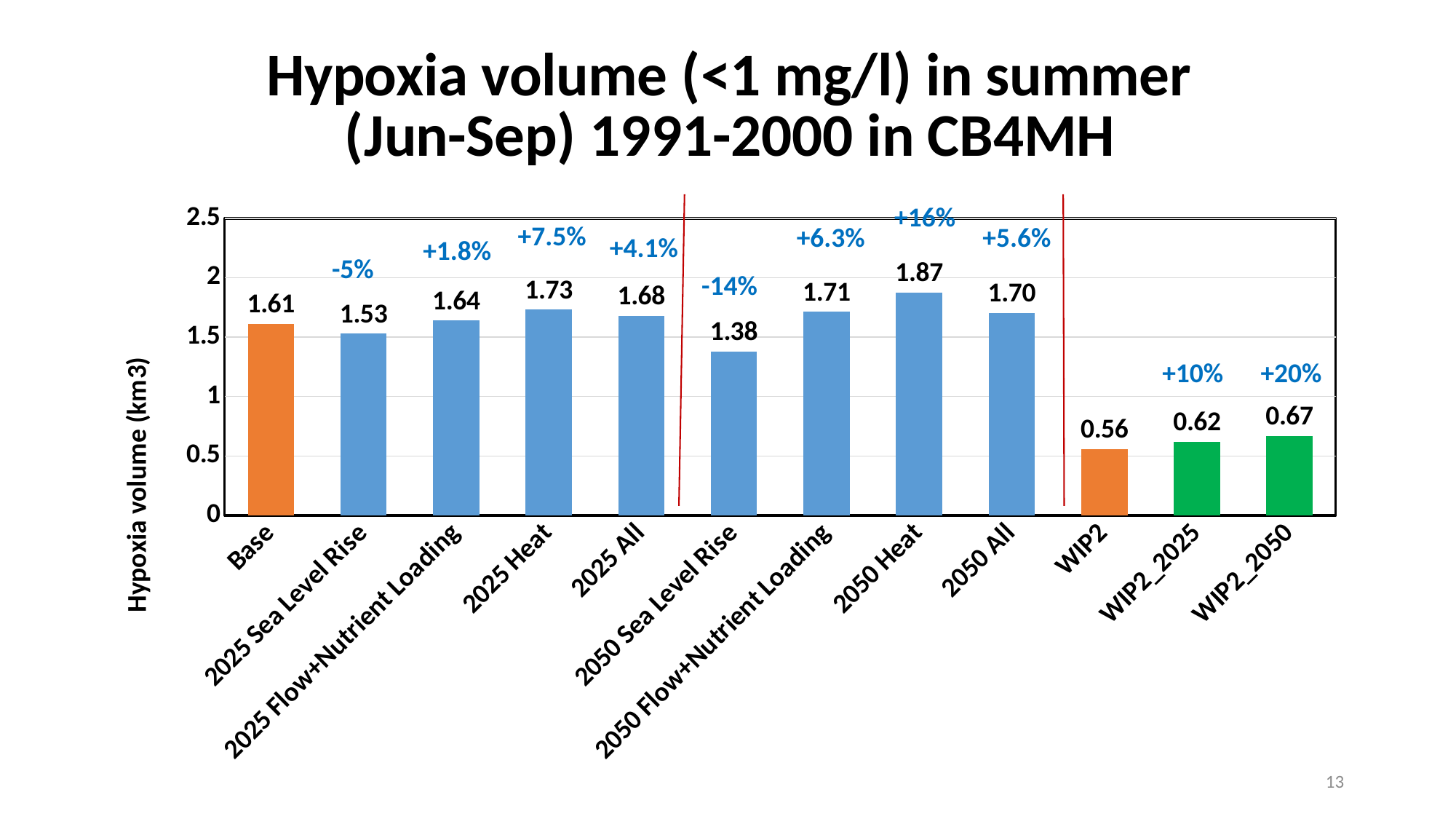
What is the hypoxia volume for WIP2_2050? 0.67 What percentage change is shown above the 2050 Heat bar? +16% What kind of chart is shown on the slide? bar chart What is the difference in hypoxia volume between 2050 Heat and Base? 0.26 What is the label of the y axis? Hypoxia volume (km3) Which has a larger hypoxia volume, 2025 Heat or 2025 All? 2025 Heat Which category has the highest hypoxia volume? 2050 Heat How many bars are shown in the chart? 12 Is the value for WIP2_2025 greater or less than 1? less What is the hypoxia volume for the Base scenario? 1.61 What is the hypoxia volume for 2050 Sea Level Rise? 1.38 Which category has the lowest hypoxia volume? WIP2